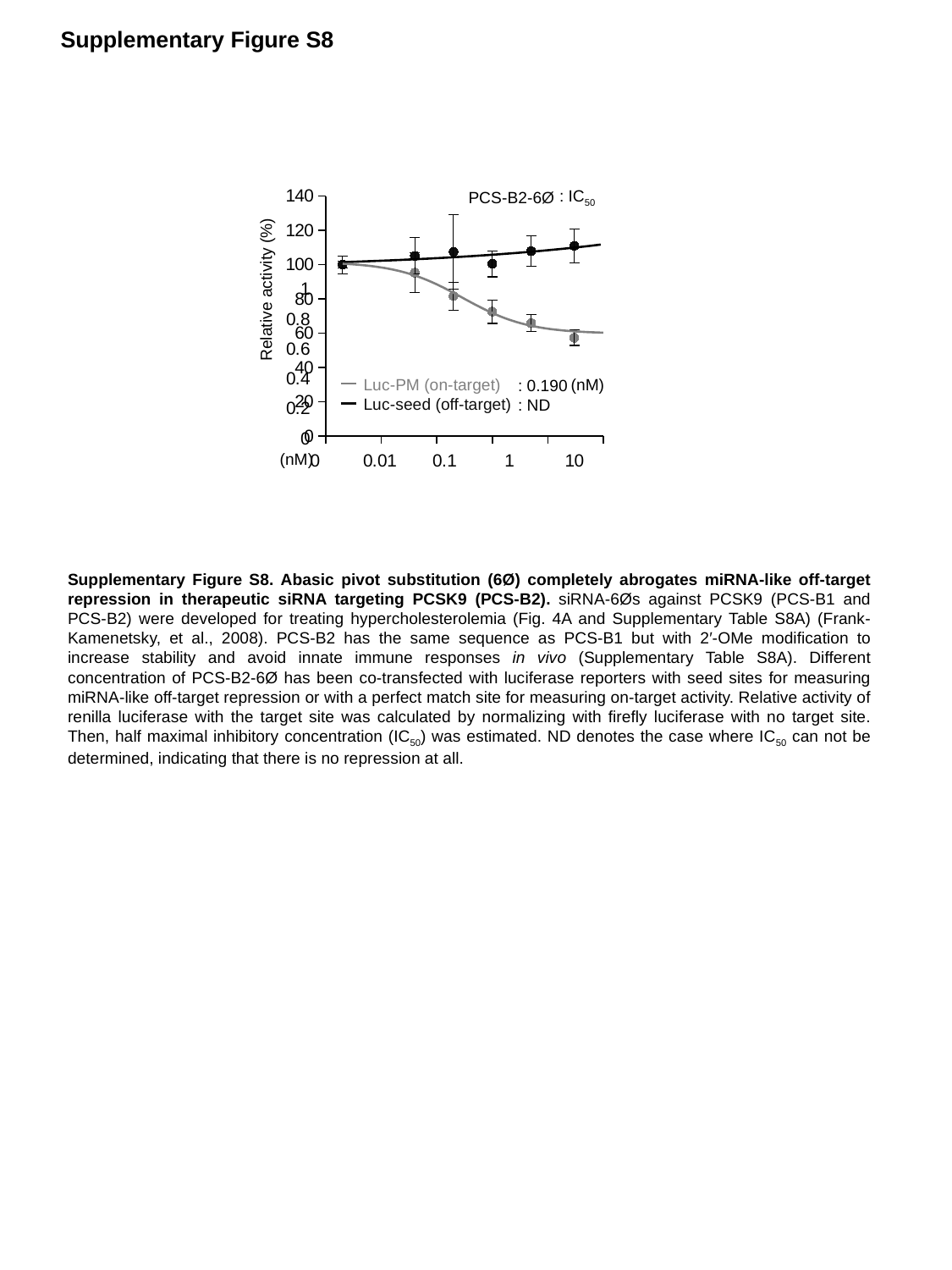
Is the relative activity of Luc-PM (on-target) at 10 nM greater or less than 80? less Which series is the lowest at the highest concentration shown (10 nM)? Luc-PM (on-target) Is the relative activity of Luc-seed (off-target) at 10 nM greater or less than 100? greater What IC50 value is given for Luc-seed (off-target)? ND Is the relative activity of Luc-PM (on-target) at 1 nM greater or less than 100? less What IC50 value is given for Luc-PM (on-target)? 0.190 (nM) How many series does the legend list? 2 At 10 nM, which series has the higher relative activity, Luc-PM (on-target) or Luc-seed (off-target)? Luc-seed (off-target) What kind of chart is shown on the slide? line chart Does the Luc-seed (off-target) series rise or fall as concentration increases along the x axis? rise Does the Luc-PM (on-target) series rise or fall as concentration increases along the x axis? fall